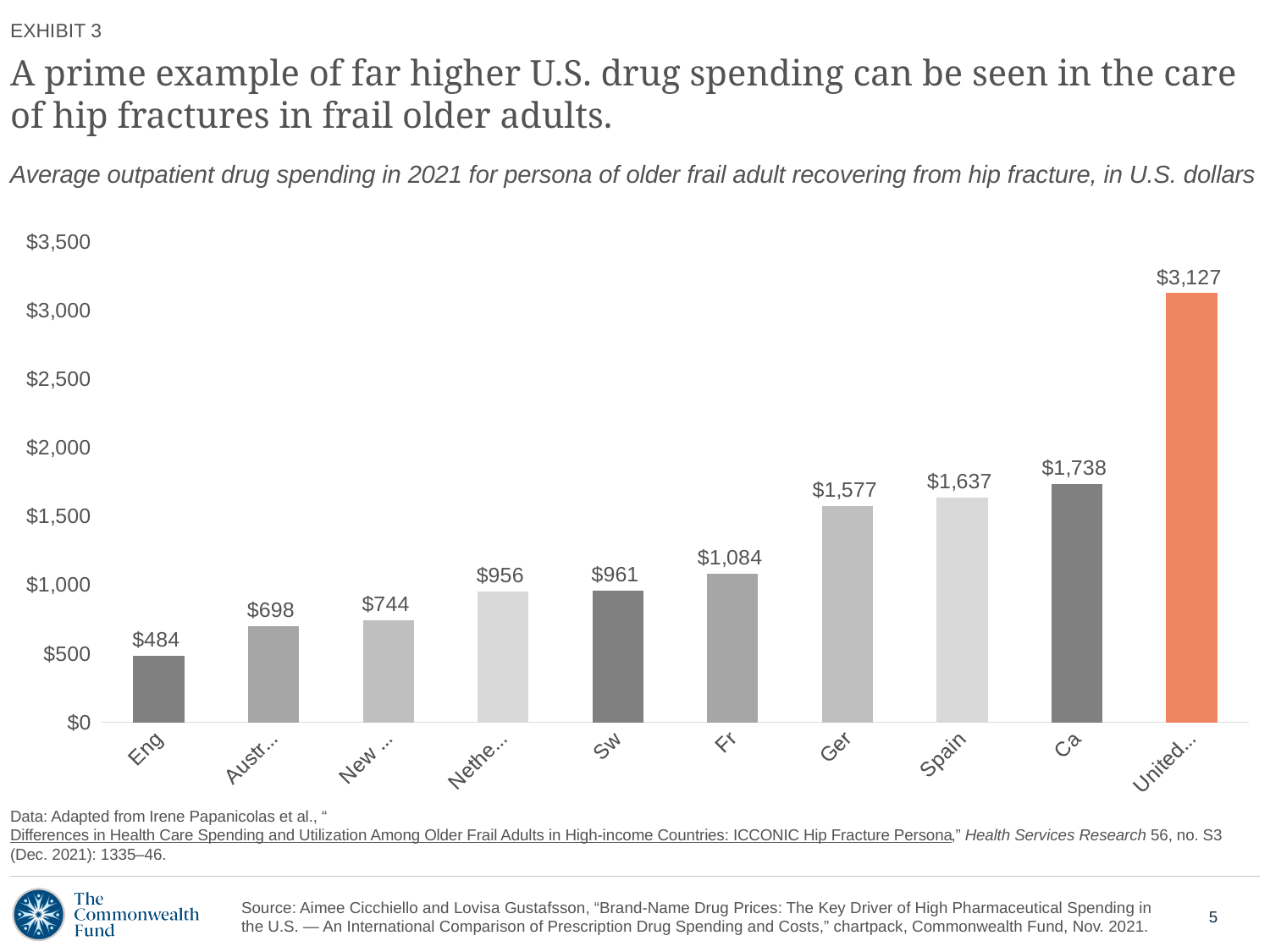
What is the difference between the bar labeled "Ca" and the bar labeled "Ger"? $161 What kind of chart is shown on the slide? Bar chart What is the difference between the rightmost bar ("United...") and Spain? $1,490 Which bar has the lowest value? The leftmost bar, labeled "Eng" What is the value for Spain? $1,637 Is the value of the rightmost bar greater or less than $3,000? greater What is the value of the rightmost bar (labeled "United...")? $3,127 Which is larger, the value for Spain or the value for the bar labeled "Ger"? Spain What is the value of the leftmost bar (labeled "Eng")? $484 Do the values rise or fall from left to right along the x axis? Rise Which bar has the highest value? The rightmost bar, labeled "United..." How many bars are shown in the chart? 10